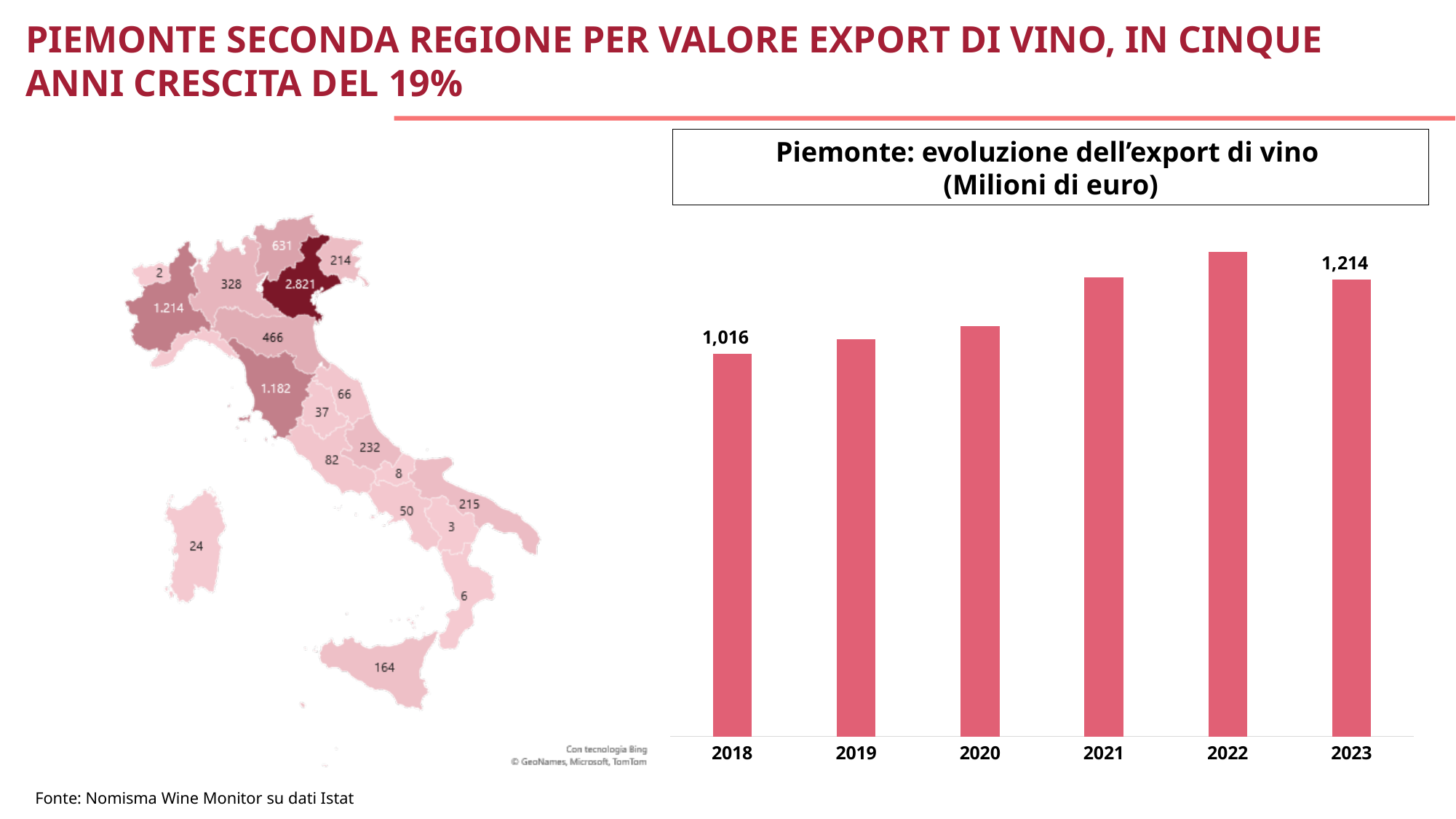
What kind of chart is 'Piemonte: evoluzione dell'export di vino'? Bar chart On the bar chart 'Piemonte: evoluzione dell'export di vino', what is the difference between the 2023 value and the 2018 value? 198 How many years are shown on the bar chart 'Piemonte: evoluzione dell'export di vino'? 6 On the bar chart 'Piemonte: evoluzione dell'export di vino', what is the value for 2018? 1,016 On the bar chart 'Piemonte: evoluzione dell'export di vino', do the values rise or fall from 2018 to 2022? Rise On the map of Italy on the left, what is the highest value printed on any region? 2.821 On the bar chart 'Piemonte: evoluzione dell'export di vino', which year has the lowest value? 2018 On the bar chart 'Piemonte: evoluzione dell'export di vino', which year has the larger value, 2019 or 2020? 2020 On the bar chart 'Piemonte: evoluzione dell'export di vino', what is the value for 2023? 1,214 What unit is stated in the title of the bar chart on the right? Milioni di euro On the bar chart 'Piemonte: evoluzione dell'export di vino', which year has the larger value, 2022 or 2023? 2022 On the bar chart 'Piemonte: evoluzione dell'export di vino', which year has the tallest bar? 2022